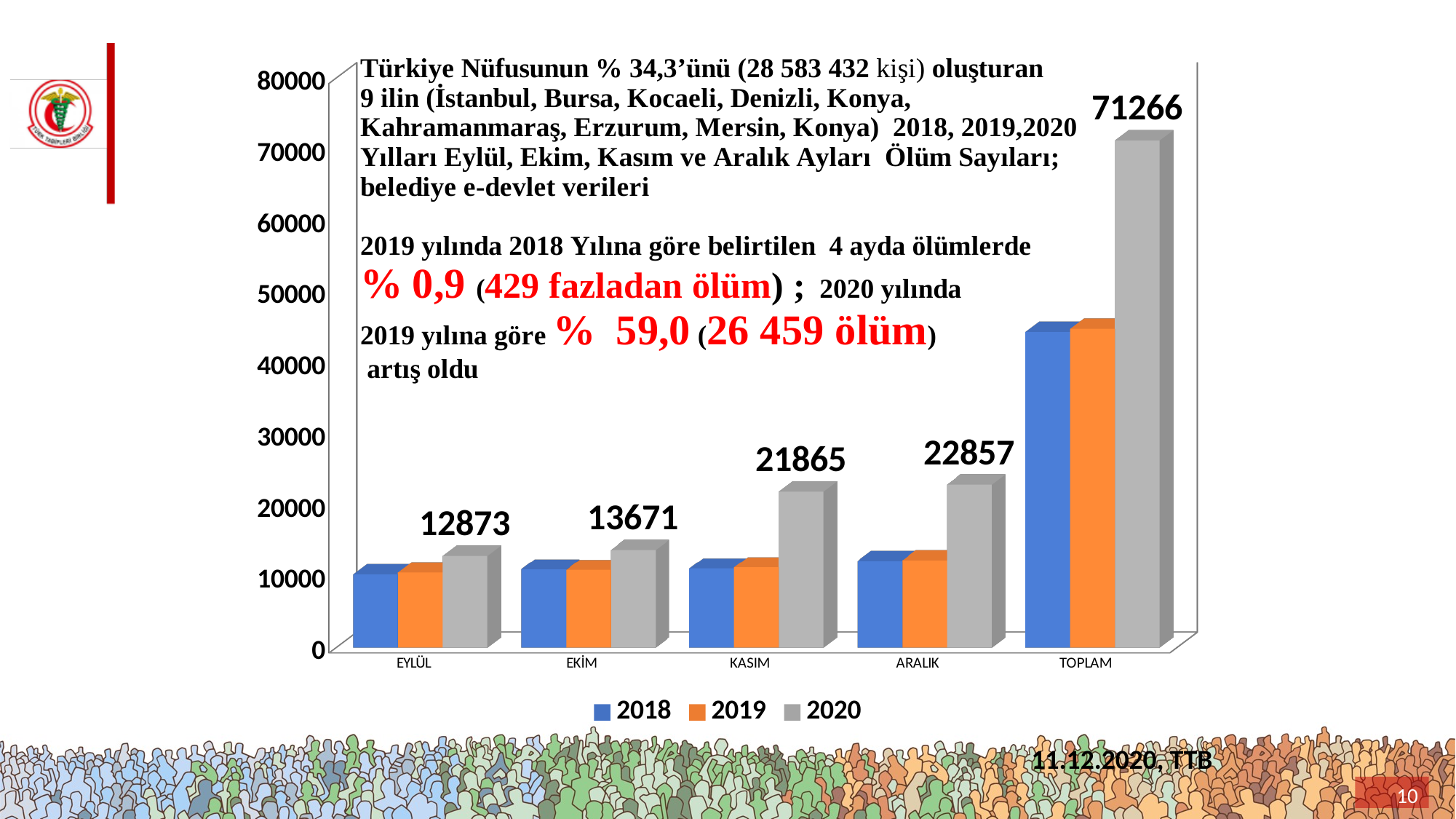
Which is larger, the 2020 value for EKİM or the 2020 value for KASIM? KASIM What is the difference between the 2020 values for ARALIK and KASIM? 992 What is the 2020 value for EYLÜL? 12873 How many categories are shown on the x axis? 5 What kind of chart is shown on the slide? bar chart Do the 2020 values rise or fall from EYLÜL to ARALIK? rise Among the four months (excluding TOPLAM), which has the highest 2020 value? ARALIK Among the four months (excluding TOPLAM), which has the lowest 2020 value? EYLÜL How many series does the legend list? 3 What is the 2020 value for TOPLAM? 71266 Is the 2018 value for TOPLAM greater or less than 40000? greater What is the 2020 value for KASIM? 21865